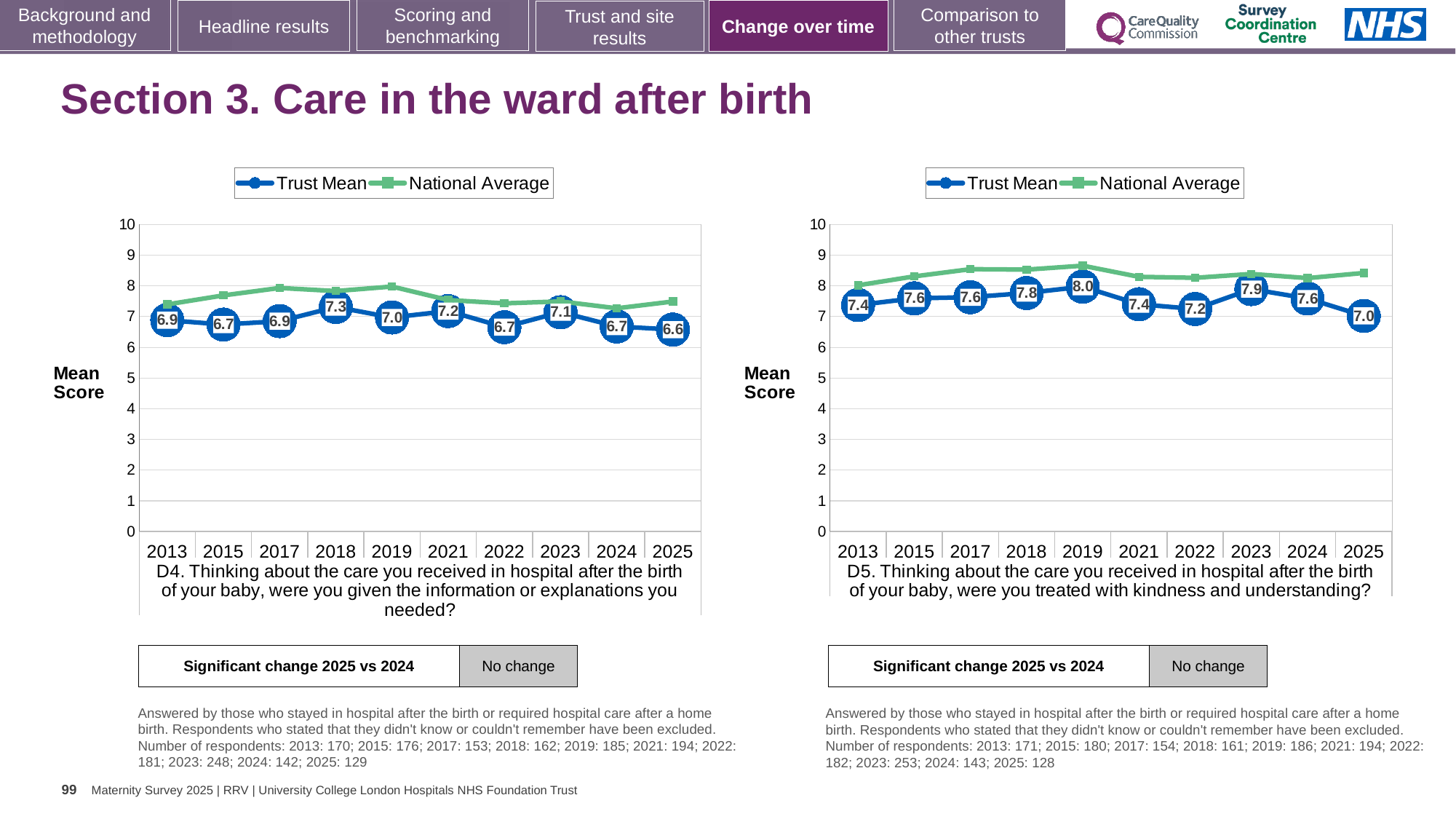
In the D5 chart (right), what is the Trust Mean for 2019? 8.0 In the D5 chart (right), how many series does the legend list? 2 In the D5 chart (right), is the National Average for 2019 greater or less than 8? greater In the D4 chart (left), which is larger: the Trust Mean in 2021 or in 2022? 2021 In the D5 chart (right), does the Trust Mean rise or fall from 2023 to 2025? Fall In the D4 chart (left), what is the Trust Mean for 2018? 7.3 In the D5 chart (right), which year has the lowest Trust Mean? 2025 In the D5 chart (right), what is the difference between the Trust Mean in 2019 and in 2025? 1.0 In the D4 chart (left), what is the label on the y axis? Mean Score In the D4 chart (left), how many years are shown on the x axis? 10 What type of chart is the D4 chart (left)? Line chart In the D4 chart (left), which year has the highest Trust Mean? 2018